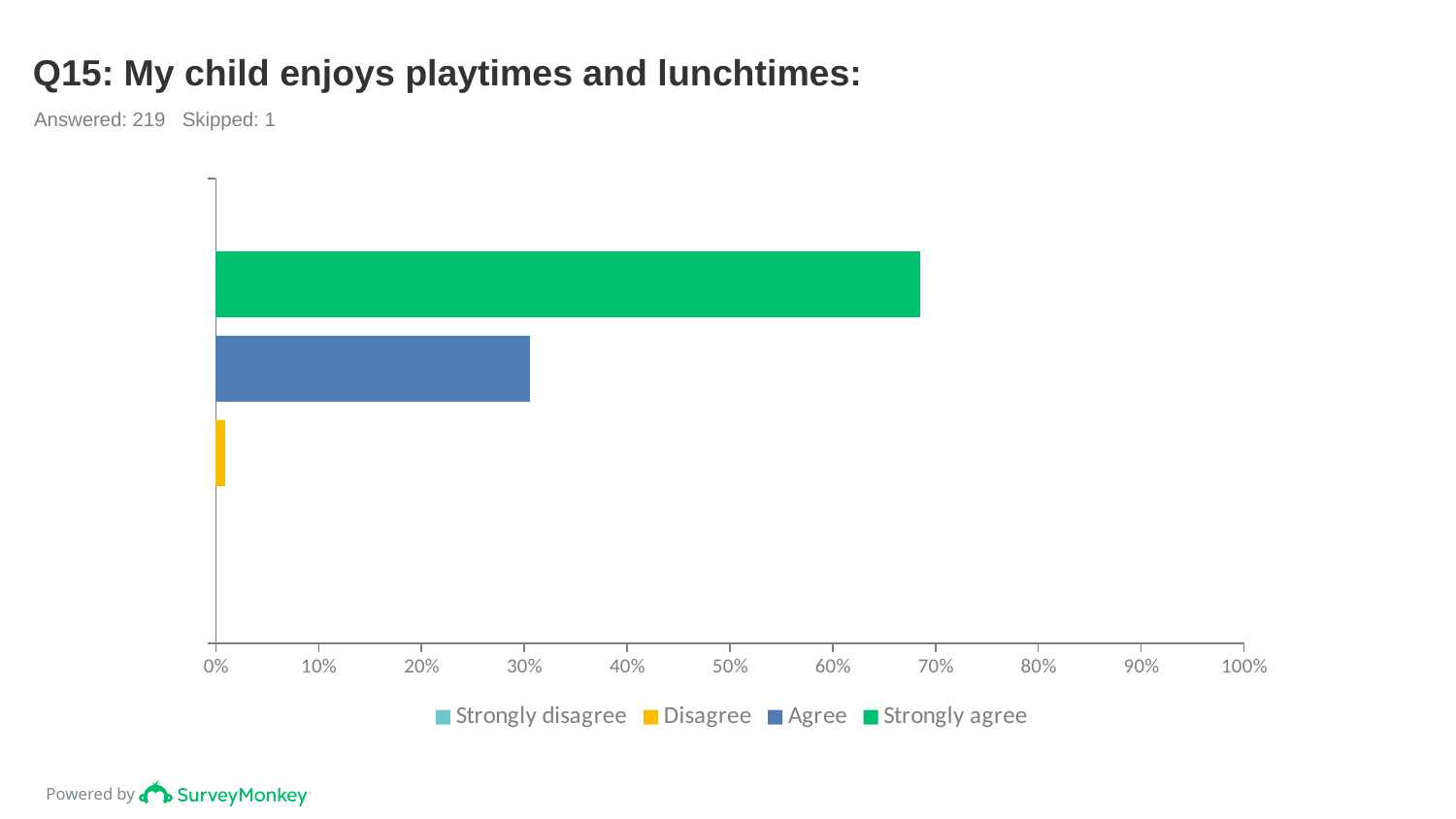
Which of the visible bars is the shortest? Disagree Is the value for Agree greater or less than 20%? greater Is the value for Strongly agree greater or less than 70%? less How many respondents answered this question according to the slide? 219 What kind of chart is shown on the slide? bar chart Is the value for Agree greater or less than 40%? less How many series does the legend list? 4 Which is larger, the value for Agree or the value for Strongly agree? Strongly agree What is the title of the chart? Q15: My child enjoys playtimes and lunchtimes: Which response category has the longest bar? Strongly agree